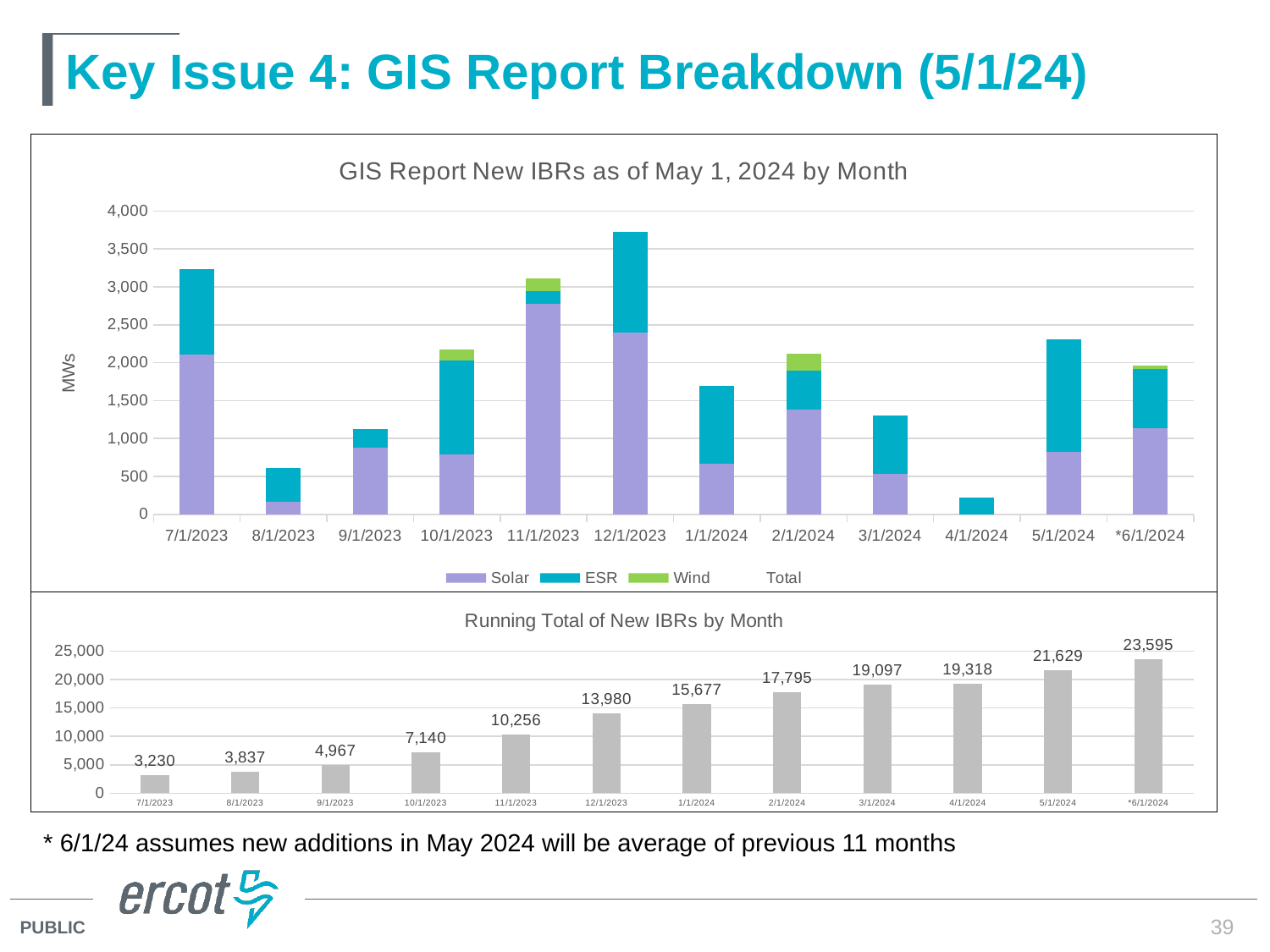
What kind of chart is the 'GIS Report New IBRs as of May 1, 2024 by Month' chart? stacked bar chart In the 'Running Total of New IBRs by Month' chart, what is the difference between the values for 5/1/2024 and *6/1/2024? 1,966 In the 'GIS Report New IBRs as of May 1, 2024 by Month' chart, which month has the shortest bar? 4/1/2024 In the 'Running Total of New IBRs by Month' chart, what is the value for *6/1/2024? 23,595 In the 'Running Total of New IBRs by Month' chart, what is the difference between the values for 11/1/2023 and 10/1/2023? 3,116 How many months are shown on the x axis of the 'Running Total of New IBRs by Month' chart? 12 In the 'GIS Report New IBRs as of May 1, 2024 by Month' chart, which month has the tallest bar? 12/1/2023 In the 'GIS Report New IBRs as of May 1, 2024 by Month' chart, is the total bar height for 8/1/2023 greater or less than 1,000? less In the 'Running Total of New IBRs by Month' chart, what is the value for 7/1/2023? 3,230 In the 'Running Total of New IBRs by Month' chart, do the values rise or fall from left to right? rise In the 'GIS Report New IBRs as of May 1, 2024 by Month' chart, is the total bar height for 12/1/2023 greater or less than 3,500? greater In the 'Running Total of New IBRs by Month' chart, what is the value for 12/1/2023? 13,980